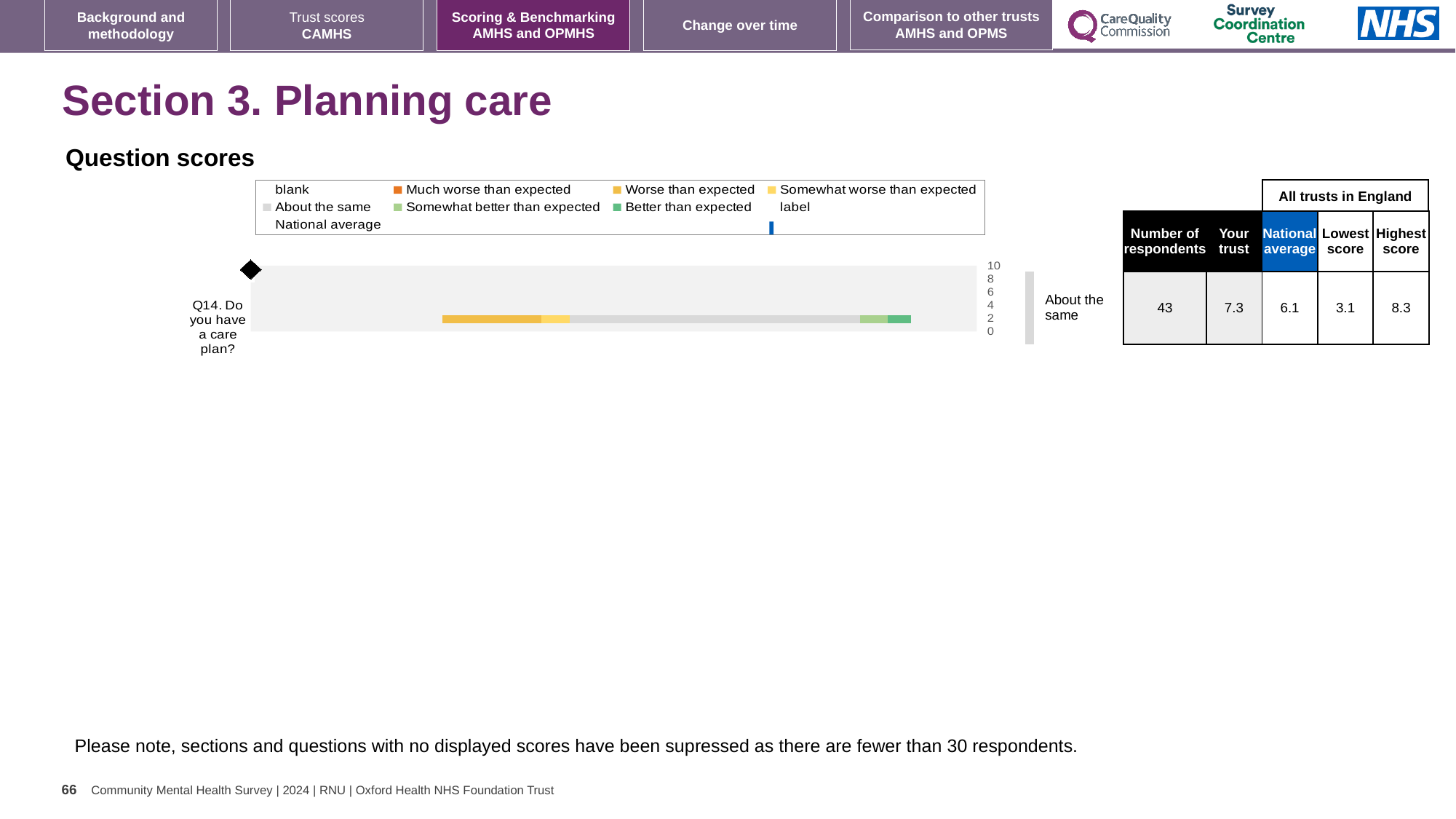
What benchmark category is shown to the right of the Q14 bar? About the same What kind of chart is used to show the Q14 question score? bar chart For Q14, what is the difference between the highest score and the lowest score among all trusts in England? 5.2 What is the highest score among all trusts in England for Q14? 8.3 How many respondents answered Q14? 43 What is the national average score for Q14 in the table beside the chart? 6.1 What is the lowest score among all trusts in England for Q14? 3.1 Which question is plotted in the Question scores chart? Q14. Do you have a care plan? For Q14, which is larger: the 'Your trust' score or the national average? Your trust How many survey questions are plotted in the Question scores chart? 1 For Q14, how much higher is the 'Your trust' score than the national average? 1.2 What is the 'Your trust' score for Q14 in the table beside the chart? 7.3